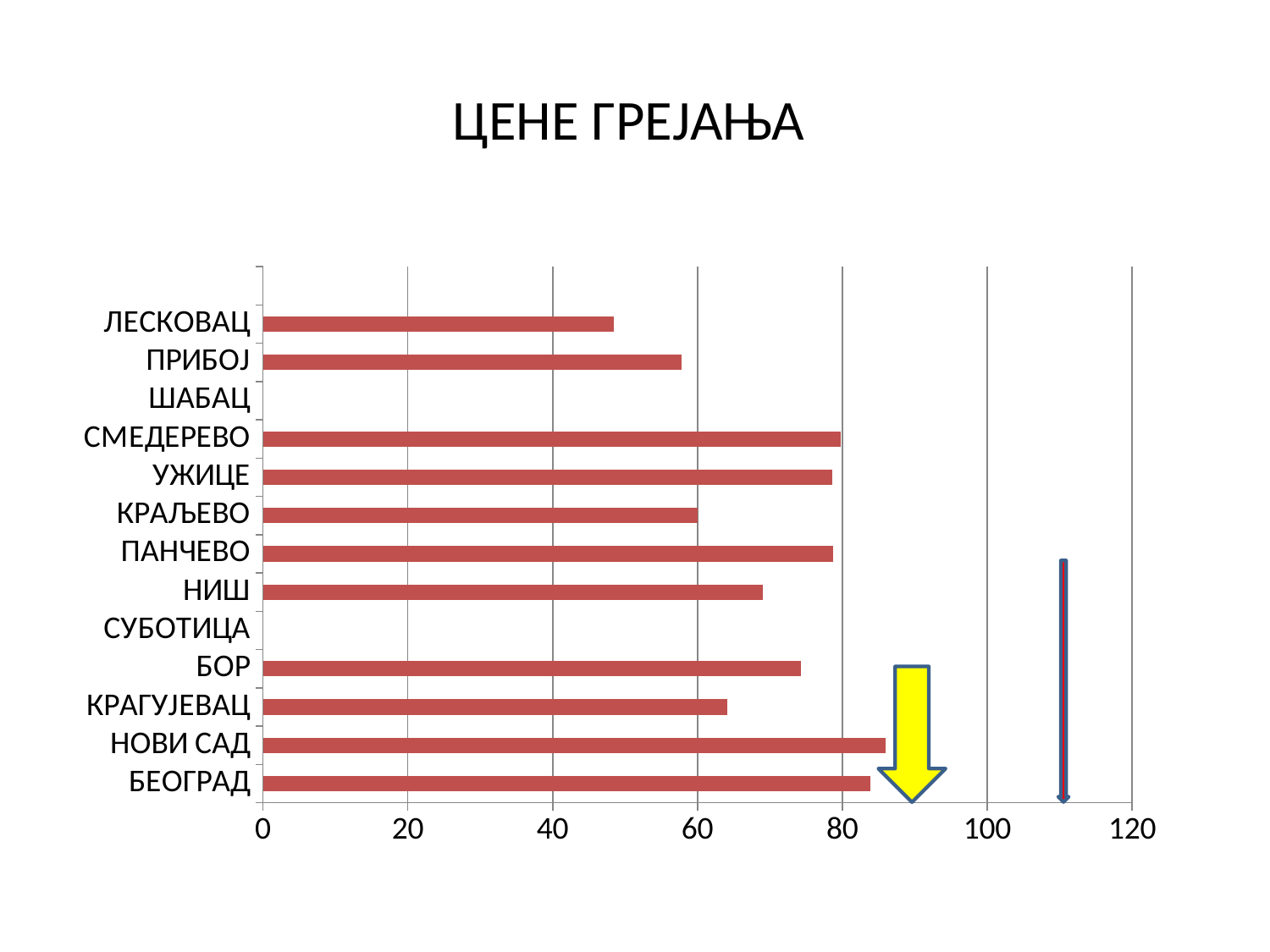
Is the value for НИШ greater or less than 80? less Is the value for ЛЕСКОВАЦ greater or less than 60? less What kind of chart is shown on the slide? bar chart Among the categories with a visible bar, which has the lowest value? ЛЕСКОВАЦ How many categories are listed on the vertical axis of the chart? 13 Which has the larger value, СМЕДЕРЕВО or КРАЉЕВО? СМЕДЕРЕВО Which has the larger value, ПРИБОЈ or НОВИ САД? НОВИ САД Which has the larger value, БОР or КРАГУЈЕВАЦ? БОР Is the value for СМЕДЕРЕВО greater or less than 60? greater Which two categories have no visible bar in the chart? ШАБАЦ and СУБОТИЦА What is the title of the chart? ЦЕНЕ ГРЕЈАЊА